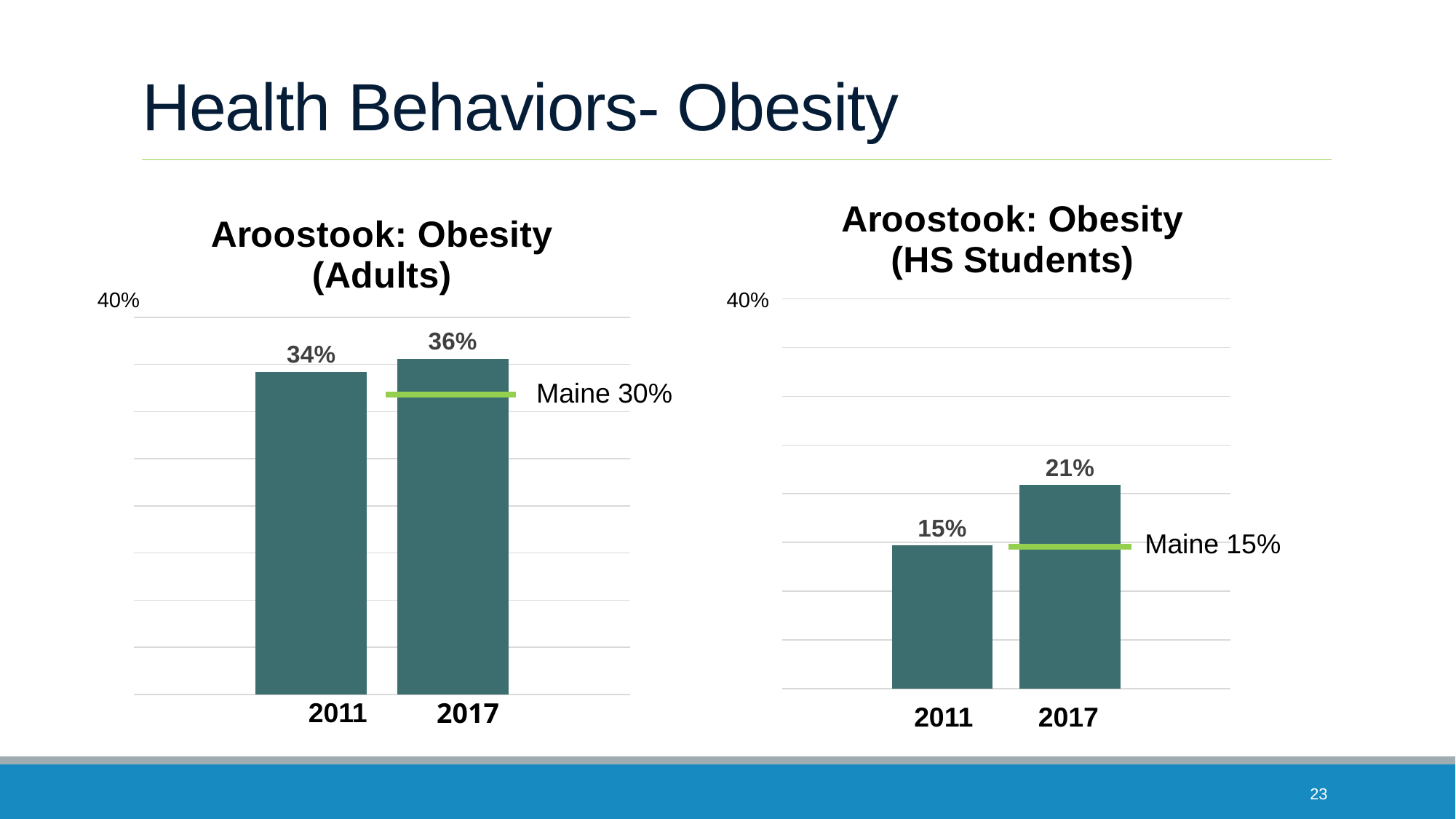
In the 'Aroostook: Obesity (HS Students)' chart, which year has the higher value? 2017 In the 'Aroostook: Obesity (Adults)' chart, what Maine value does the green reference line mark? 30% In the 'Aroostook: Obesity (HS Students)' chart, what is the value for 2017? 21% In the 'Aroostook: Obesity (HS Students)' chart, what is the value for 2011? 15% How many bars are in the 'Aroostook: Obesity (Adults)' chart? 2 In the 'Aroostook: Obesity (Adults)' chart, which year has the lower value? 2011 In the 'Aroostook: Obesity (Adults)' chart, what is the value for 2011? 34% In the 'Aroostook: Obesity (Adults)' chart, what is the value for 2017? 36% In the 'Aroostook: Obesity (Adults)' chart, what is the difference between the 2017 and 2011 values? 2% In the 'Aroostook: Obesity (HS Students)' chart, what is the difference between the 2017 and 2011 values? 6% In the 'Aroostook: Obesity (HS Students)' chart, do the values rise or fall from 2011 to 2017? rise What kind of chart is the 'Aroostook: Obesity (HS Students)' chart? bar chart